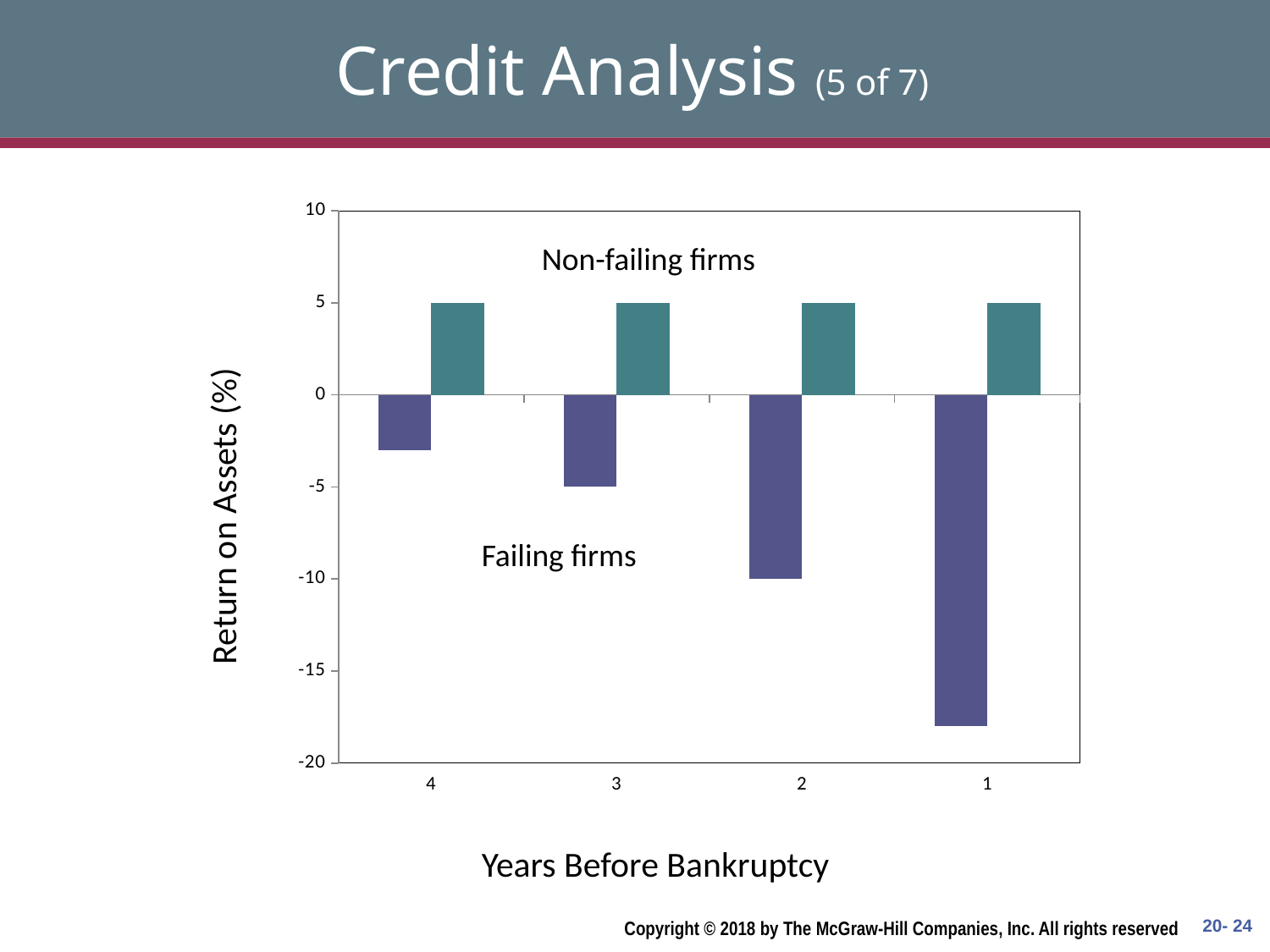
Which is larger for failing firms: the return on assets 3 years before bankruptcy or 2 years before bankruptcy? 3 years before bankruptcy How many categories are shown on the x axis of the chart? 4 What is the return on assets for failing firms 2 years before bankruptcy? -10 Is the value for failing firms 4 years before bankruptcy greater or less than -5? greater What is the return on assets for non-failing firms 4 years before bankruptcy? 5 What is the title of the x axis of the chart? Years Before Bankruptcy What is the difference between the failing firms' return on assets 3 years and 2 years before bankruptcy? 5 Do the values for failing firms rise or fall moving from left to right along the x axis? fall What kind of chart is shown on the slide? bar chart Is the value for failing firms 1 year before bankruptcy greater or less than -15? less At how many years before bankruptcy do failing firms have the lowest return on assets? 1 What is the return on assets for failing firms 3 years before bankruptcy? -5